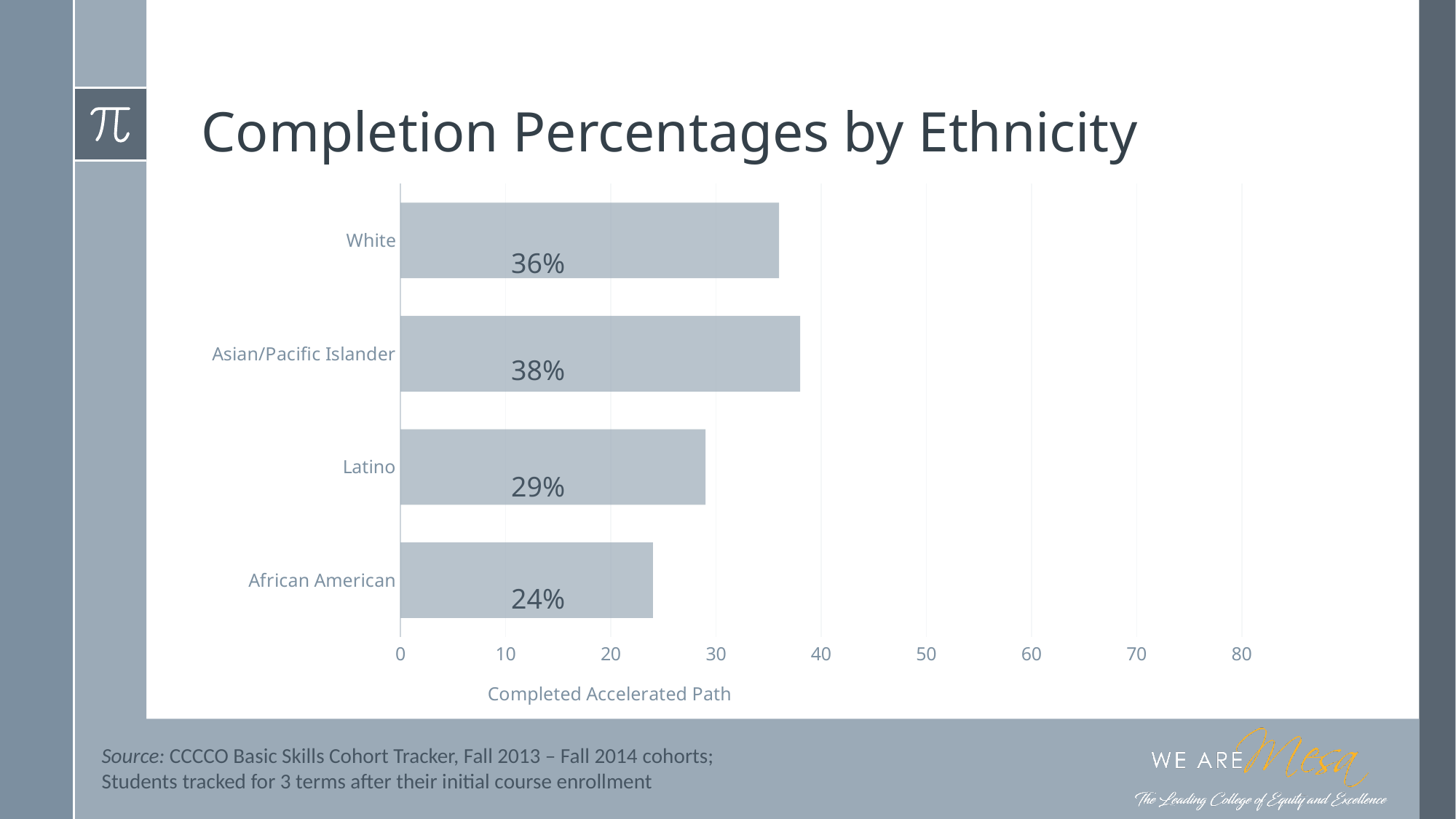
What is the label on the horizontal axis of the chart? Completed Accelerated Path What is the completion percentage for African American students? 24% What kind of chart is shown on the slide? Bar chart Which ethnicity has the highest completion percentage? Asian/Pacific Islander What is the difference between the completion percentages for Asian/Pacific Islander and African American students? 14% What is the completion percentage for Latino students? 29% Which has a higher completion percentage, Latino or White students? White What is the completion percentage for White students? 36% What is the difference between the completion percentages for White and Latino students? 7% Which ethnicity has the lowest completion percentage? African American How many ethnicity categories are shown in the chart? 4 What is the completion percentage for Asian/Pacific Islander students? 38%